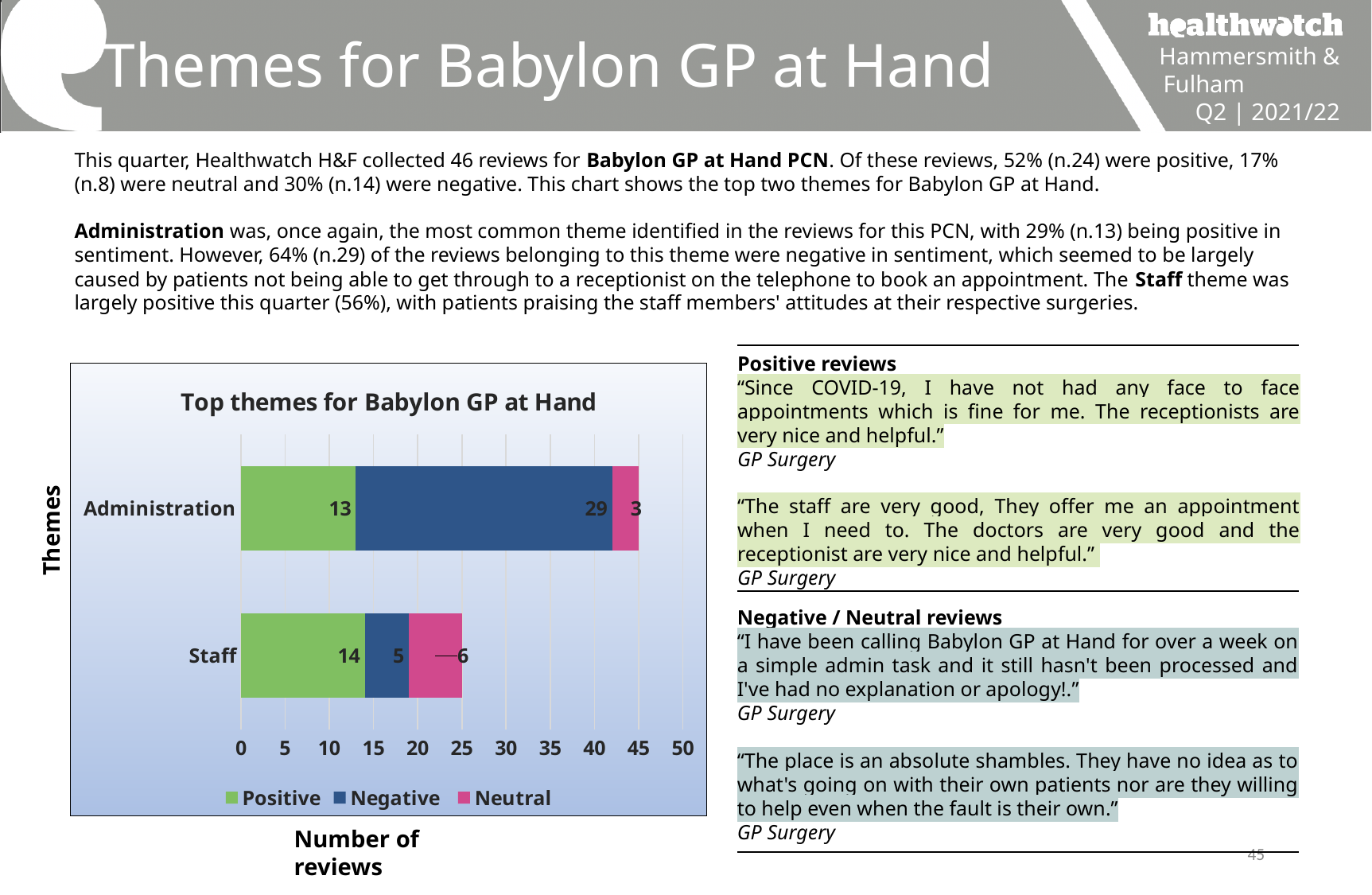
What kind of chart is shown? Stacked bar chart What is the title of the chart? Top themes for Babylon GP at Hand What is the total number of reviews in the Staff bar? 25 What is the total number of reviews in the Administration bar? 45 What is the difference between the Negative values for Administration and Staff? 24 How many series does the legend list? 3 What is the Neutral value for Staff? 6 What is the Positive value for Administration? 13 What is the Negative value for Administration? 29 How many themes are shown on the chart? 2 What is the Negative value for Staff? 5 Which theme has the higher Negative value, Administration or Staff? Administration